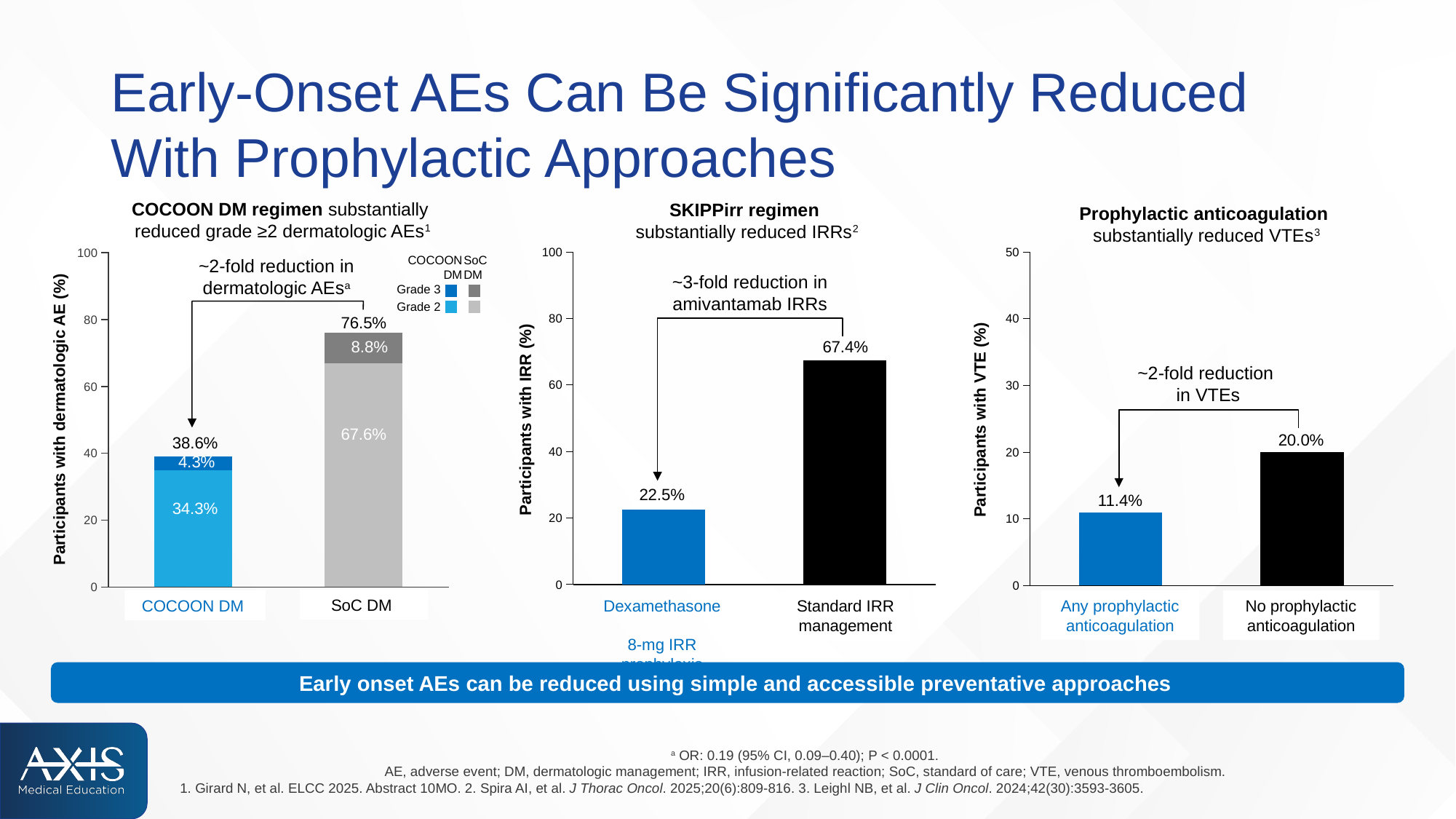
What kind of chart is the SKIPPirr regimen chart (middle)? Bar chart In the COCOON DM regimen chart (left), what is the total percentage of participants with dermatologic AE for SoC DM? 76.5% In the Prophylactic anticoagulation chart (right), what is the maximum value shown on the y axis? 50 In the SKIPPirr regimen chart (middle), what percentage of participants had an IRR with Dexamethasone? 22.5% In the COCOON DM regimen chart (left), what is the difference between the total for SoC DM and the total for COCOON DM? 37.9% In the Prophylactic anticoagulation chart (right), which category has the lowest value? Any prophylactic anticoagulation In the Prophylactic anticoagulation chart (right), what is the value for No prophylactic anticoagulation? 20.0% In the SKIPPirr regimen chart (middle), what is the difference between Standard IRR management and Dexamethasone? 44.9% In the SKIPPirr regimen chart (middle), which category has the higher value? Standard IRR management In the COCOON DM regimen chart (left), how many grade categories does the legend list? 2 In the COCOON DM regimen chart (left), what is the Grade 2 value for COCOON DM? 34.3% In the COCOON DM regimen chart (left), what is the Grade 3 value for SoC DM? 8.8%